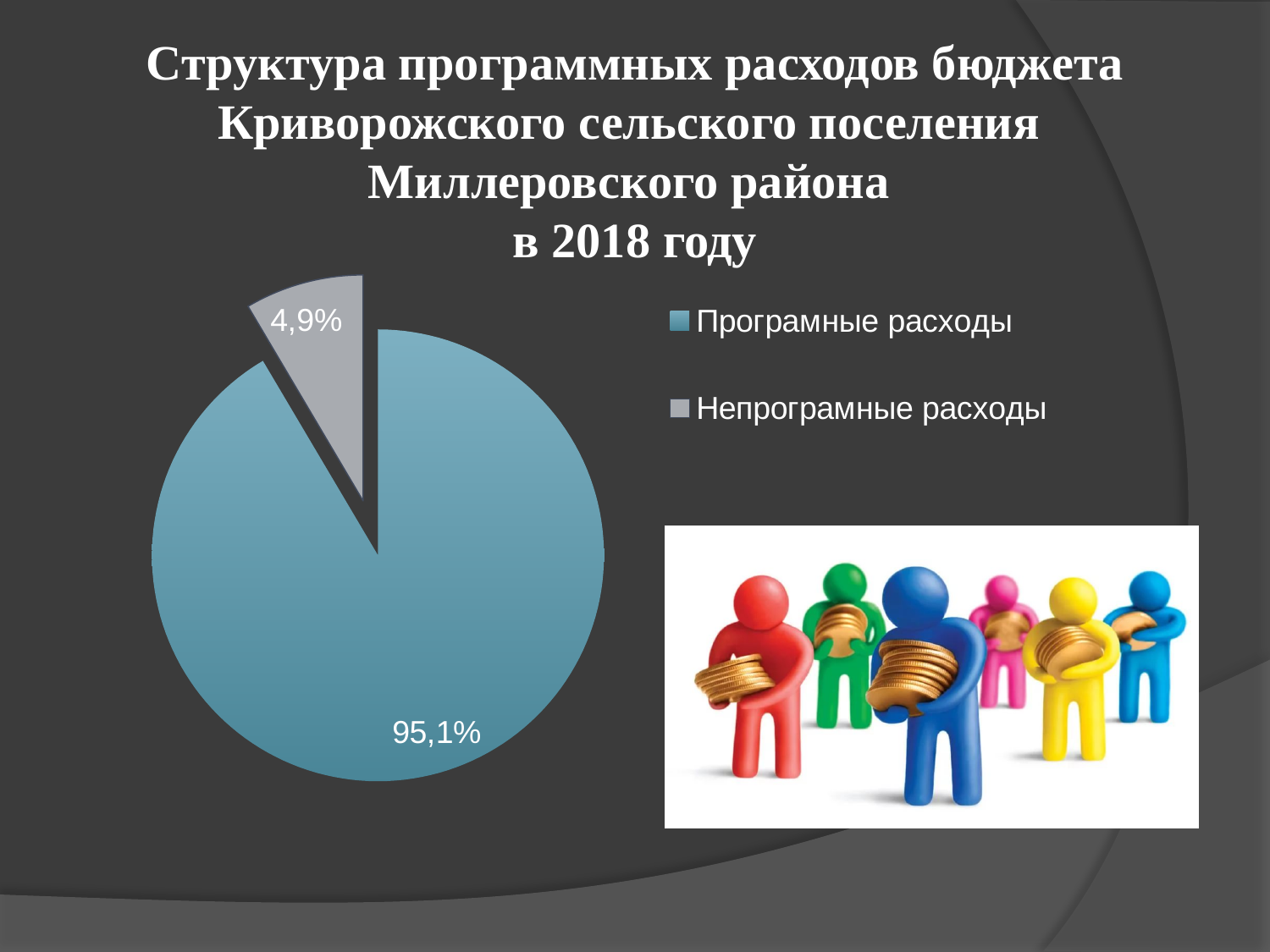
How many entries does the legend list? 2 What is the difference in percentage points between the Програмные расходы slice and the Непрограмные расходы slice? 90,2 What colour is the Непрограмные расходы slice? grey Which slice of the pie is the smallest? Непрограмные расходы What share of the pie is labelled for Програмные расходы? 95,1% Which is larger, the Програмные расходы slice or the Непрограмные расходы slice? Програмные расходы Which year does the slide title say the budget structure refers to? 2018 Which slice of the pie is the largest? Програмные расходы What kind of chart is shown on the slide? pie chart How many slices does the pie chart have? 2 What share of the pie is labelled for Непрограмные расходы? 4,9%